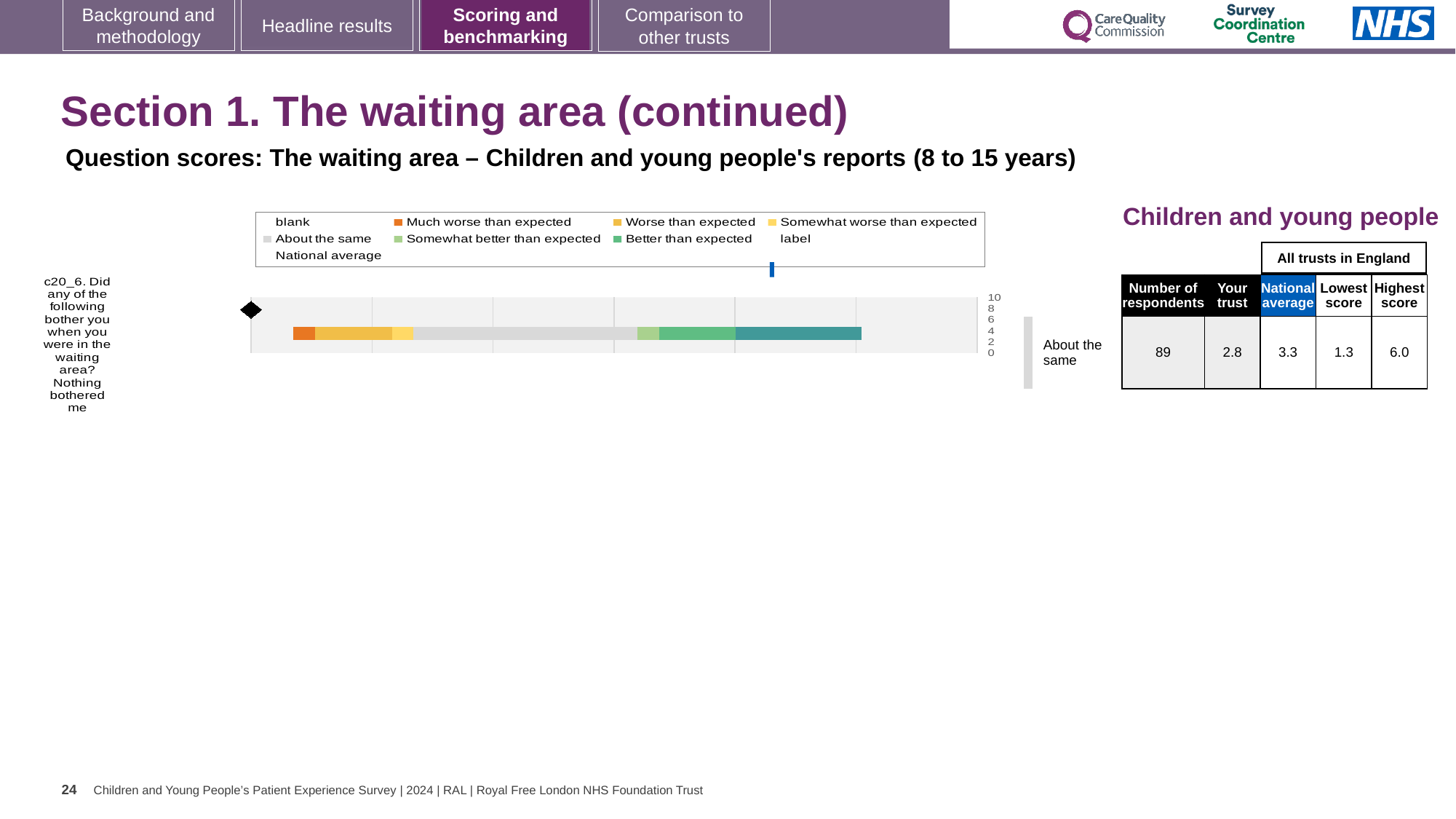
In the table next to the chart, what is the Highest score among all trusts in England? 6.0 In the table next to the chart, what is the difference between the Highest score and the Lowest score? 4.7 In the table next to the chart, what is the National average score? 3.3 How many entries does the chart legend list? 9 What kind of chart is shown on the slide? bar chart In the table next to the chart, which is larger: the Your trust score or the National average? National average Which legend entry is shown in orange? Much worse than expected What benchmark label is printed to the right of the bar for question c20_6? About the same In the table next to the chart, what is the 'Your trust' score for question c20_6? 2.8 In the table next to the chart, what is the Lowest score among all trusts in England? 1.3 How many questions (categories) are plotted in the bar chart? 1 In the table next to the chart, what is the Number of respondents? 89